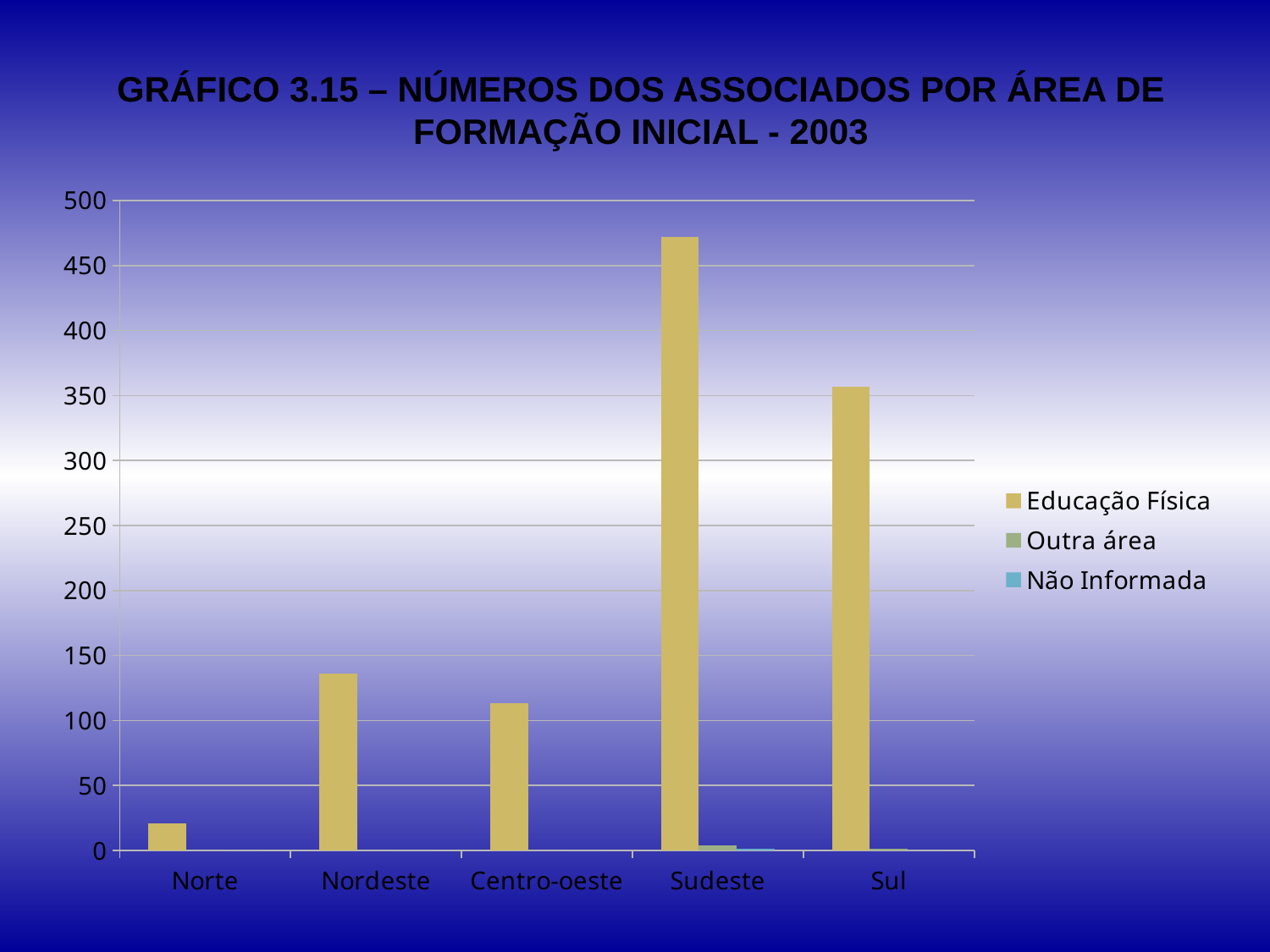
Which is larger for Educação Física: Nordeste or Centro-oeste? Nordeste Which is larger for Educação Física: Sul or Sudeste? Sudeste What kind of chart is shown on the slide? bar chart How many regions are shown on the x axis? 5 How many series does the legend list? 3 Which series is shown in the legend with the blue colour? Não Informada Is the Educação Física value for Centro-oeste greater or less than 100? greater Which region has the highest value for Educação Física? Sudeste Is the Educação Física value for Sudeste greater or less than 450? greater Is the Educação Física value for Sul greater or less than 400? less Which region has the lowest value for Educação Física? Norte